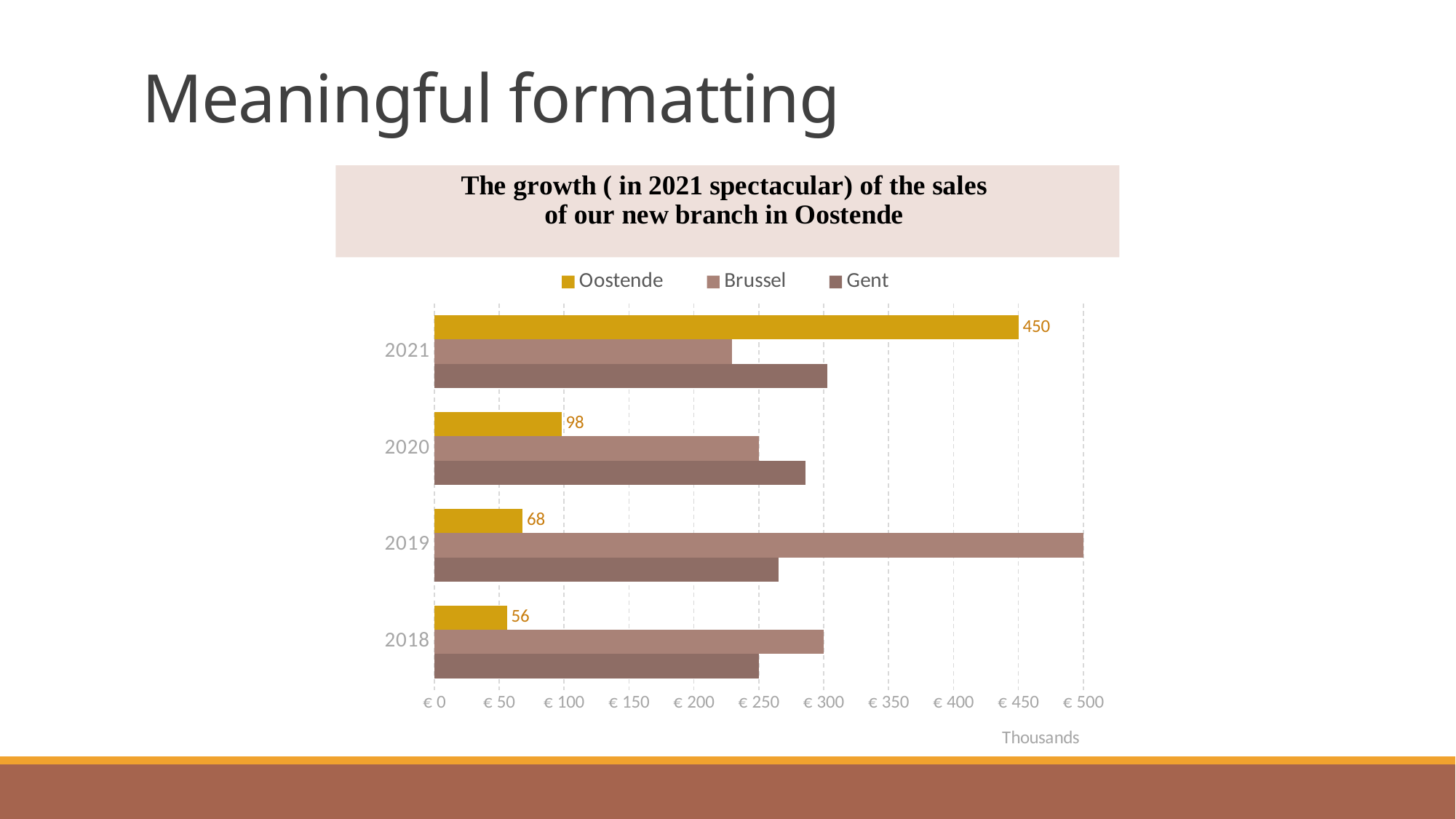
What is the value for Oostende in 2020? 98 How many series does the legend list? 3 How many years are shown on the chart? 4 What is the difference between the Oostende values for 2021 and 2020? 352 Which is larger in 2021, the Oostende bar or the Brussel bar? Oostende Is the value for Brussel in 2021 greater or less than 250? less What is the value for Oostende in 2018? 56 What kind of chart is shown on the slide? bar chart What is the value for Oostende in 2021? 450 In which year is the Oostende value highest? 2021 Is the value for Brussel in 2019 greater or less than 450? greater In which year is the Oostende value lowest? 2018